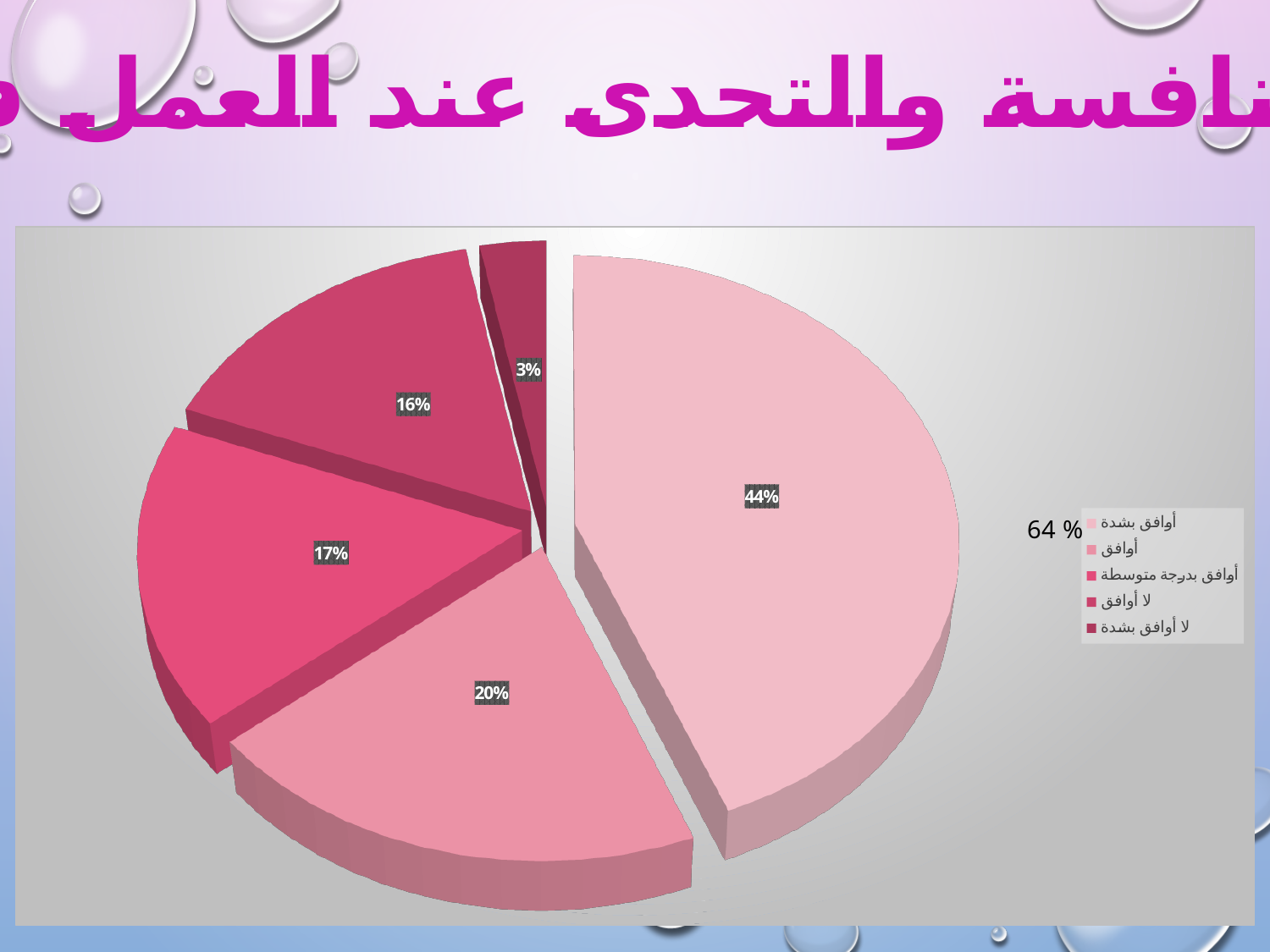
What percentage is shown for the slice labelled لا أوافق بشدة? 3% What percentage is shown for the slice labelled أوافق بشدة? 44% What kind of chart is shown on the slide? pie chart Which slice is larger, لا أوافق or لا أوافق بشدة? لا أوافق Which category has the largest slice of the pie? أوافق بشدة What percentage is shown for the slice labelled أوافق بدرجة متوسطة? 17% Which category has the smallest slice of the pie? لا أوافق بشدة What value is written as a text annotation next to the legend? 64 % What is the difference in percentage points between the أوافق بشدة slice and the أوافق slice? 24 How many slices does the pie chart have? 5 How many entries does the legend list? 5 What percentage is shown for the slice labelled أوافق? 20%